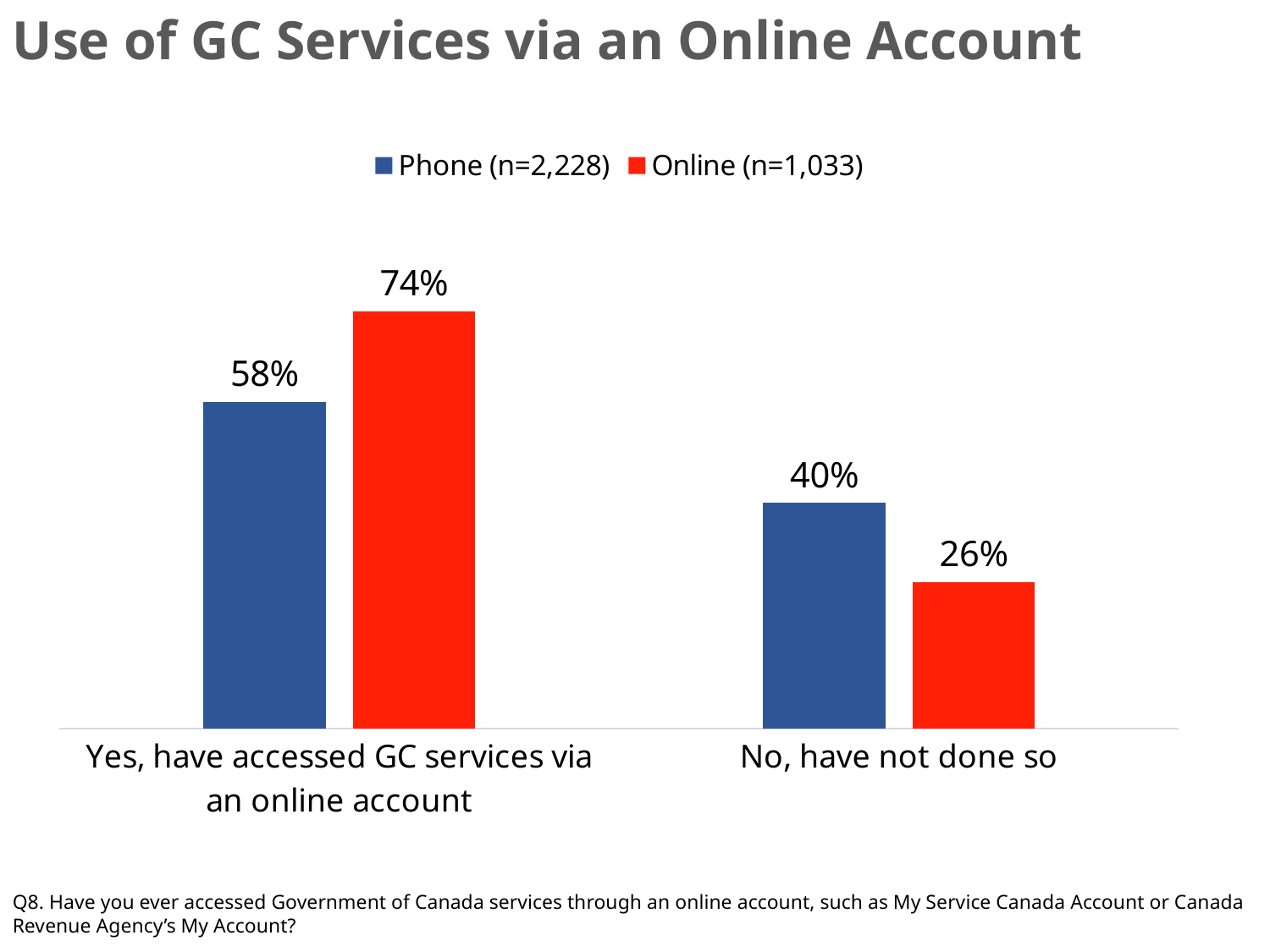
How many series does the legend list? 2 What percentage of Online respondents answered 'No, have not done so'? 26% What is the difference between the Phone and Online values for 'No, have not done so'? 14% What is the difference between the Online and Phone values for 'Yes, have accessed GC services via an online account'? 16% What percentage of Phone respondents have accessed GC services via an online account? 58% Which series has the higher value for 'Yes, have accessed GC services via an online account'? Online (n=1,033) Which bar has the highest value on the chart? Online, Yes, have accessed GC services via an online account (74%) What percentage of Online respondents have accessed GC services via an online account? 74% What percentage of Phone respondents have not accessed GC services via an online account? 40% Which bar has the lowest value on the chart? Online, No, have not done so (26%) What type of chart is shown on the slide? Bar chart Which series has the higher value for 'No, have not done so'? Phone (n=2,228)